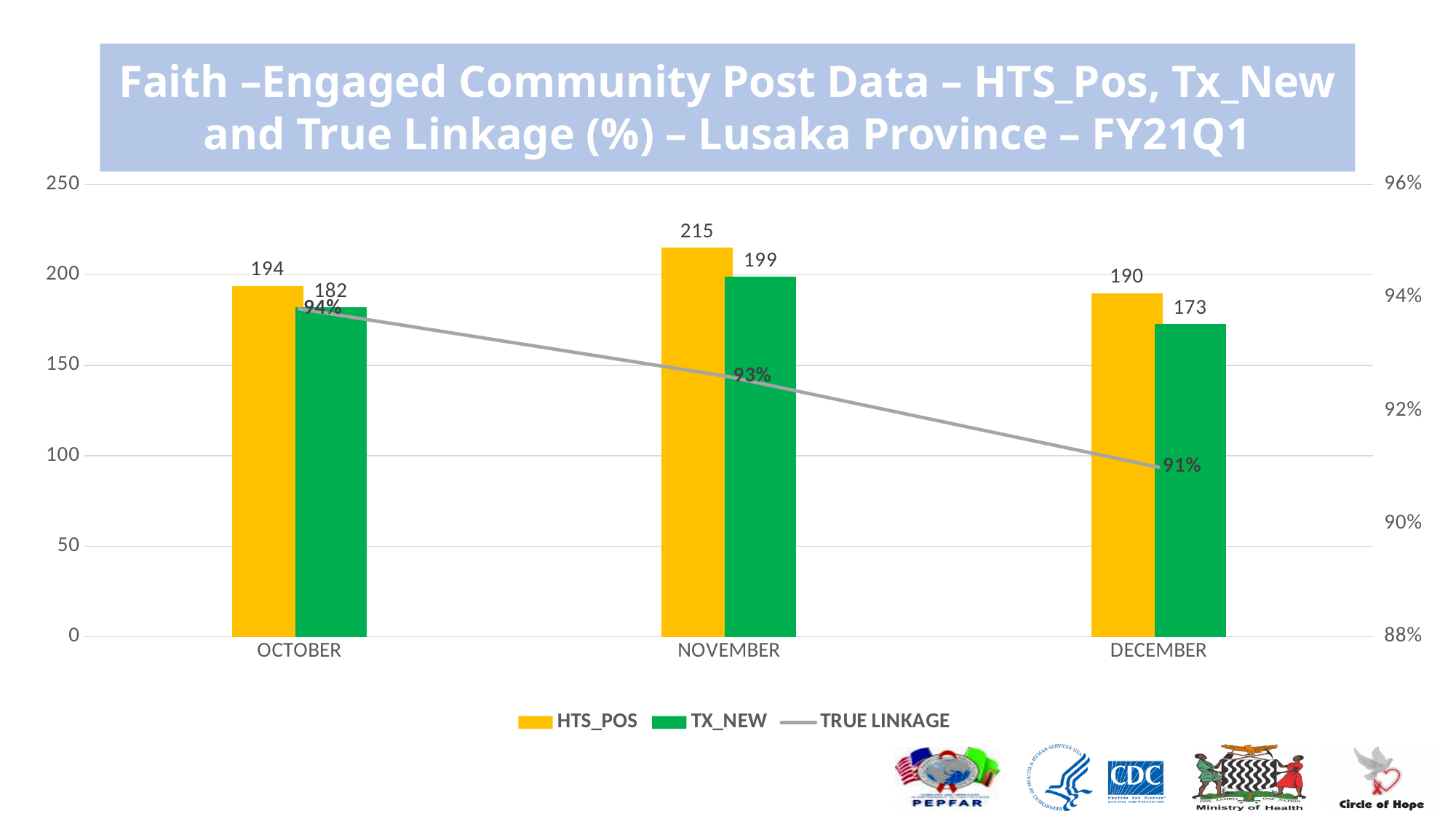
Which is larger, the TX_NEW value for November or the HTS_POS value for December? TX_NEW for November What kind of chart is this? Combined bar and line chart What is the TRUE LINKAGE percentage for October? 94% How many series does the legend list? 3 What is the HTS_POS value for November? 215 Which colour represents the TX_NEW series? Green What is the difference between HTS_POS and TX_NEW in October? 12 What is the TX_NEW value for December? 173 Does the TRUE LINKAGE line rise or fall from October to December? Fall Which month has the lowest TX_NEW value? DECEMBER How many months are shown on the x axis? 3 Which month has the highest HTS_POS value? NOVEMBER